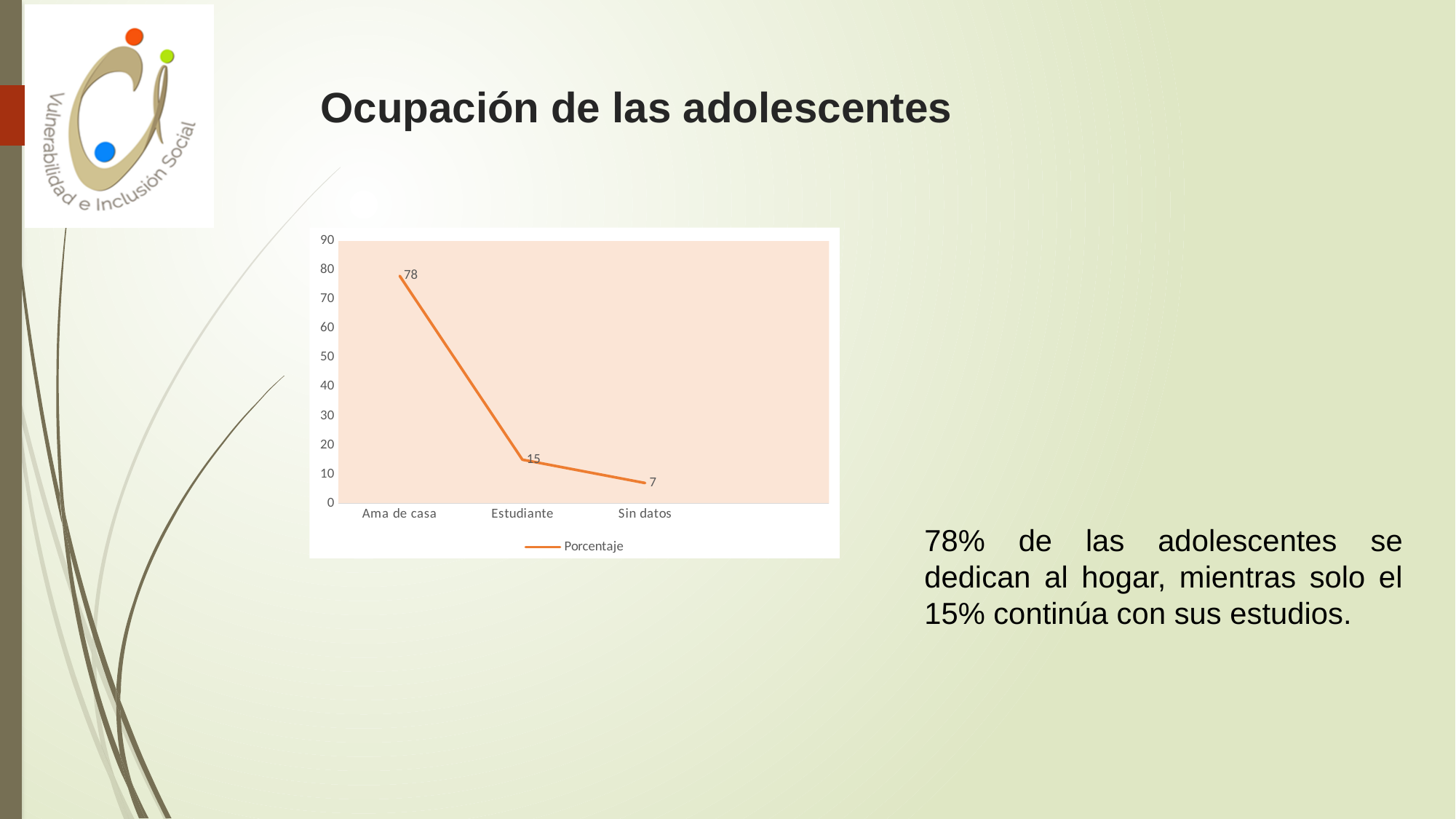
What is the value for Sin datos? 7 What kind of chart is shown on the slide? line chart How many categories are shown on the x axis? 3 What is the difference between the values for Ama de casa and Estudiante? 63 Which is larger, the value for Estudiante or the value for Sin datos? Estudiante Is the value for Ama de casa greater or less than 70? greater What is the value for Estudiante? 15 What is the value for Ama de casa? 78 Which category has the lowest value? Sin datos Which category has the highest value? Ama de casa Do the values rise or fall from Ama de casa to Sin datos? fall What is the difference between the values for Estudiante and Sin datos? 8